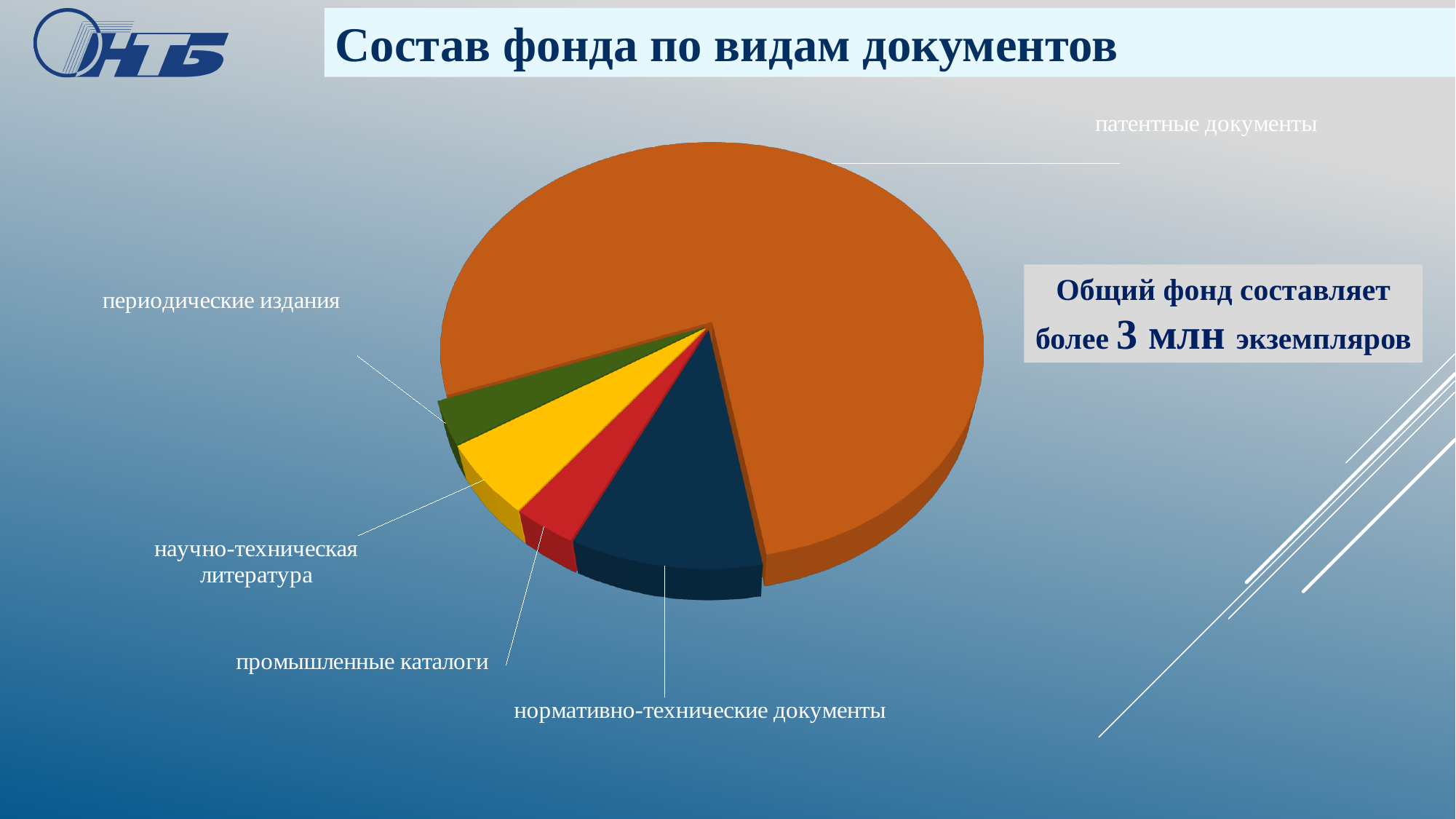
Which is larger in the pie chart: патентные документы or периодические издания? патентные документы What colour is the slice for патентные документы in the pie chart? orange What kind of chart is shown on the slide? pie chart How many slices does the pie chart have? 5 Which is larger in the pie chart: патентные документы or нормативно-технические документы? патентные документы Which category has the largest slice of the pie chart? патентные документы Which is larger in the pie chart: нормативно-технические документы or промышленные каталоги? нормативно-технические документы What is the title of the slide containing the pie chart? Состав фонда по видам документов